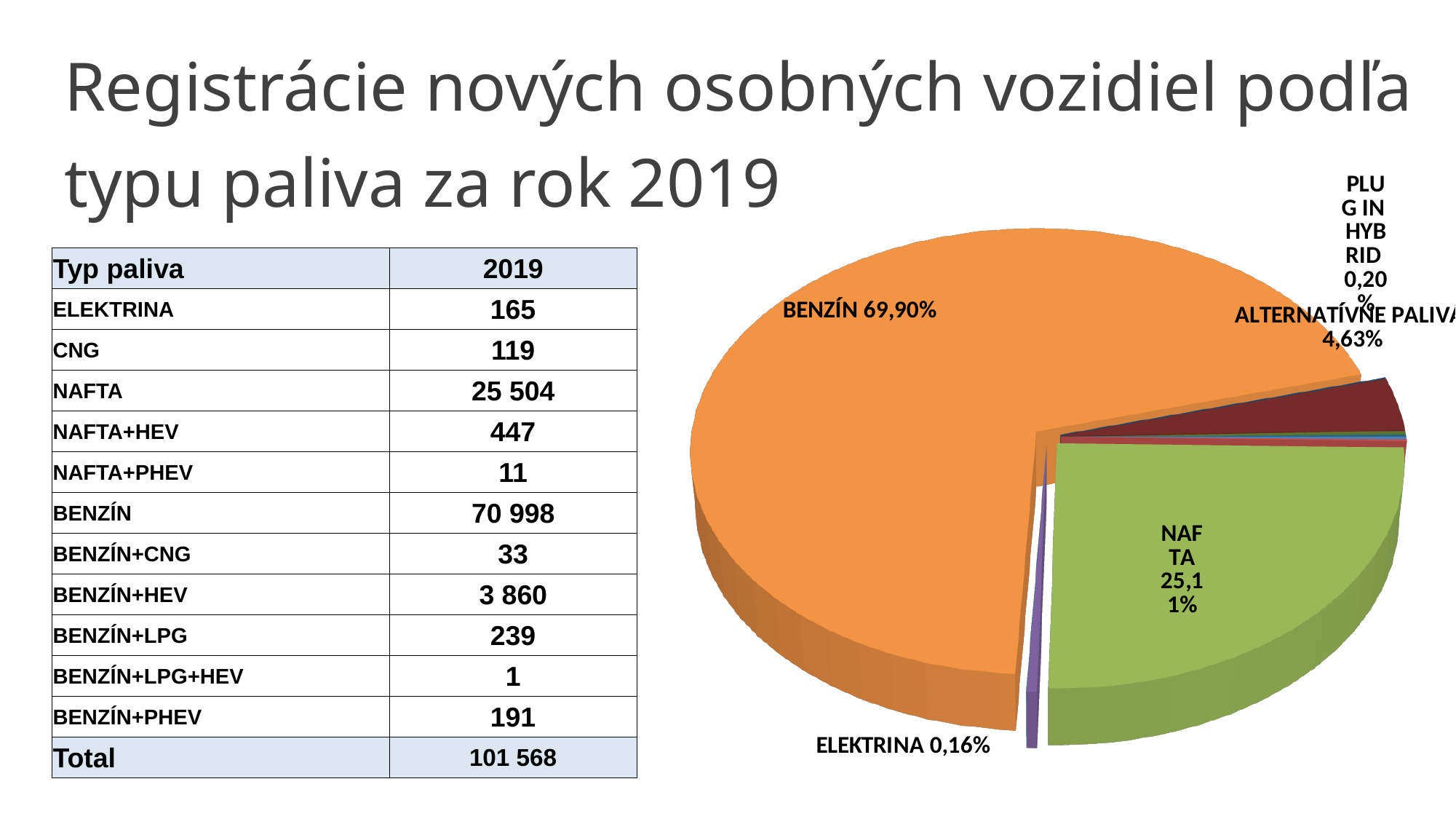
What share of the pie does PLUG IN HYBRID hold? 0,20% What colour is the BENZÍN slice of the pie chart? orange Which slice of the pie chart is the largest? BENZÍN What share of the pie does ELEKTRINA hold? 0,16% What kind of chart is shown on the slide? pie chart Which is larger in the pie chart, NAFTA or ALTERNATÍVNE PALIVÁ? NAFTA What share of the pie does ALTERNATÍVNE PALIVÁ hold? 4,63% What is the difference in percentage points between the BENZÍN and NAFTA slices? 44,79 How many labelled slices does the pie chart have? 5